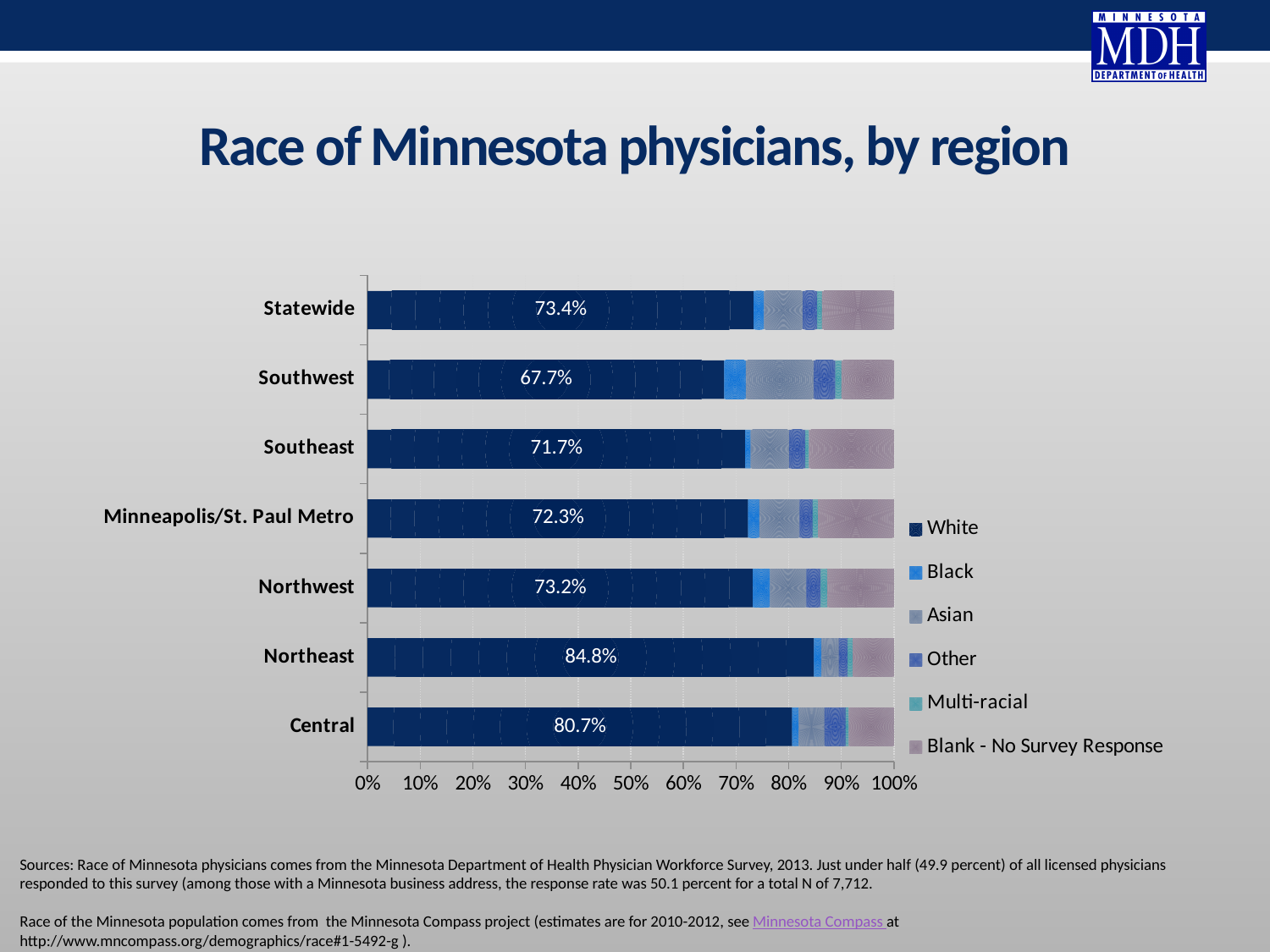
How many series does the legend list? 6 What percentage of physicians in the Northeast region are White? 84.8% Which region has the lowest percentage of White physicians? Southwest What is the White share of physicians in the Southwest region? 67.7% What is the title of the chart? Race of Minnesota physicians, by region Which region has the highest percentage of White physicians? Northeast Is the White percentage for the Southwest region greater or less than 70%? less What is the difference between the White percentage in the Northeast and in Central? 4.1% What is the Statewide percentage of White physicians? 73.4% What type of chart is shown on the slide? Stacked bar chart Which region has a larger White share of physicians, Southeast or Minneapolis/St. Paul Metro? Minneapolis/St. Paul Metro How many regions (categories) are shown on the chart? 7